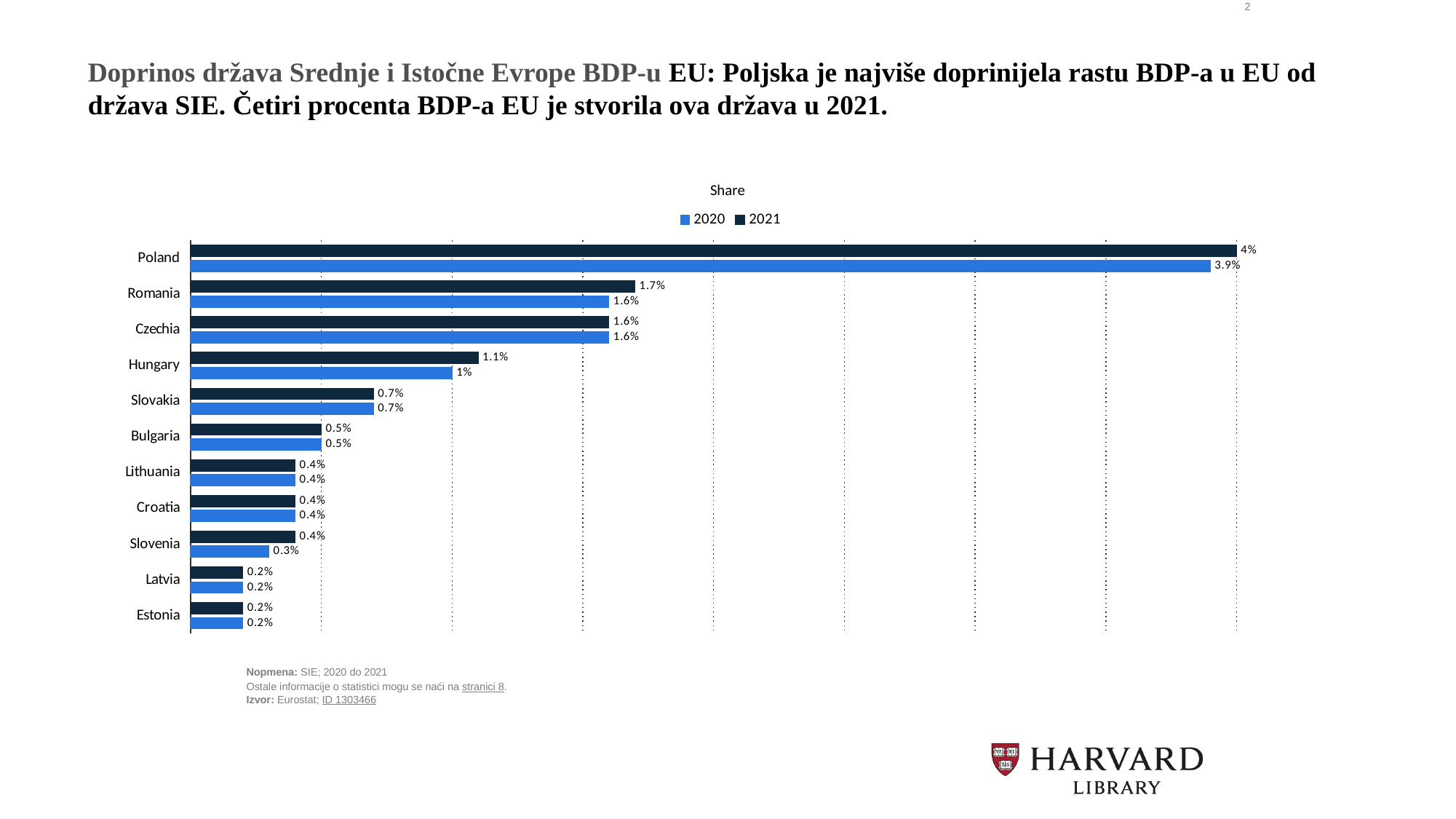
What is the 2021 share for Romania? 1.7% What is the 2020 share for Slovenia? 0.3% What is the 2020 share for Hungary? 1% How many countries are shown in the chart? 11 What is the 2020 share for Poland? 3.9% Which country has the highest 2021 share? Poland What kind of chart is shown on the slide? bar chart What is the title of the chart? Share What is the 2021 share for Poland? 4% How many series does the legend list? 2 Which is larger, Romania's 2021 share or Hungary's 2021 share? Romania's 2021 share What is the difference between Poland's 2021 share and Romania's 2021 share? 2.3%